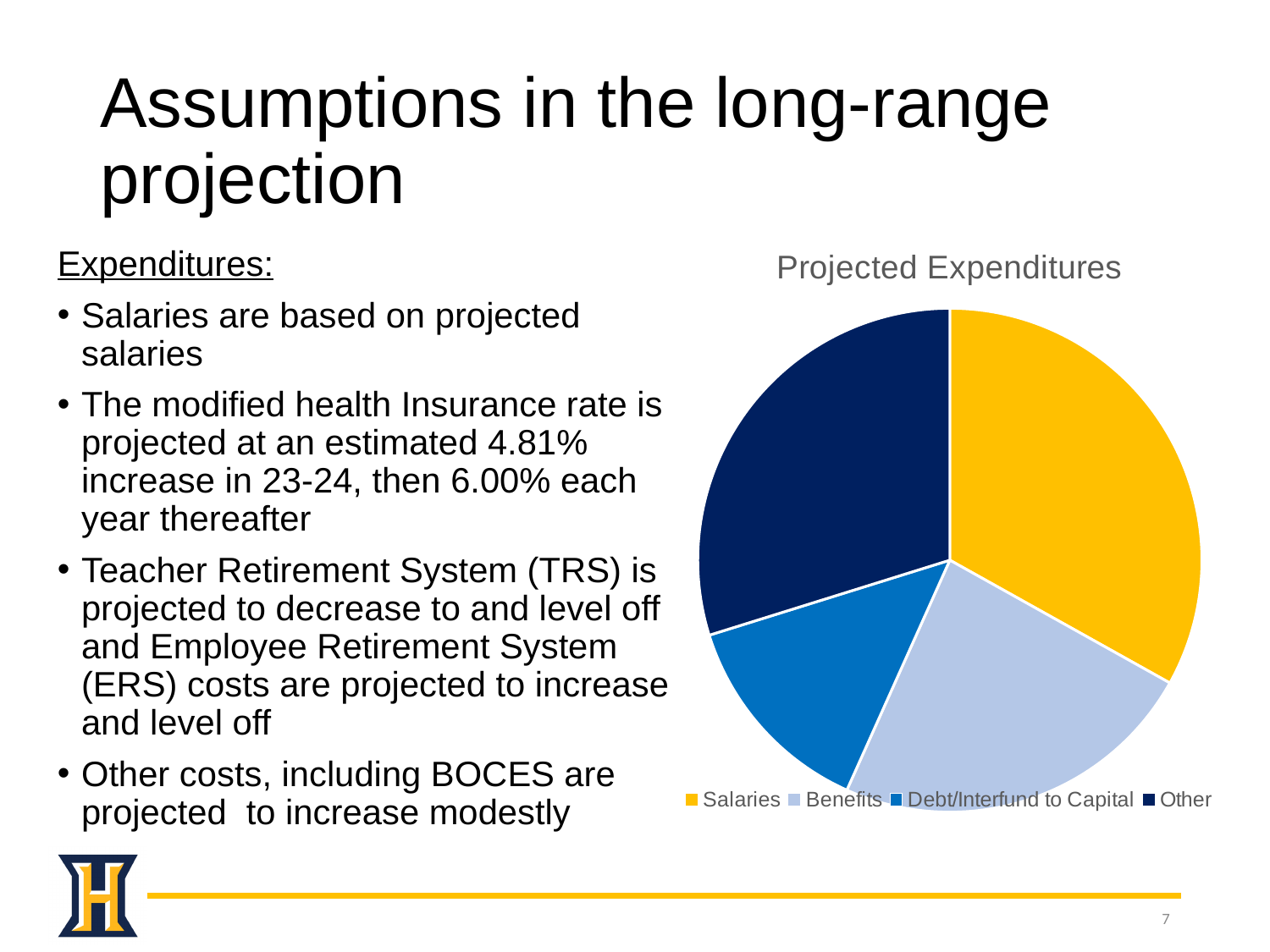
Which slice is larger, Salaries or Debt/Interfund to Capital? Salaries Which category has the largest slice of the pie? Salaries Which slice is larger, Other or Benefits? Other How many entries does the chart legend list? 4 How many slices does the pie chart have? 4 Which colour represents Salaries in the pie chart? yellow Which category has the smallest slice of the pie? Debt/Interfund to Capital What kind of chart is shown on the slide? pie chart What is the title of the chart? Projected Expenditures Which slice is larger, Benefits or Debt/Interfund to Capital? Benefits